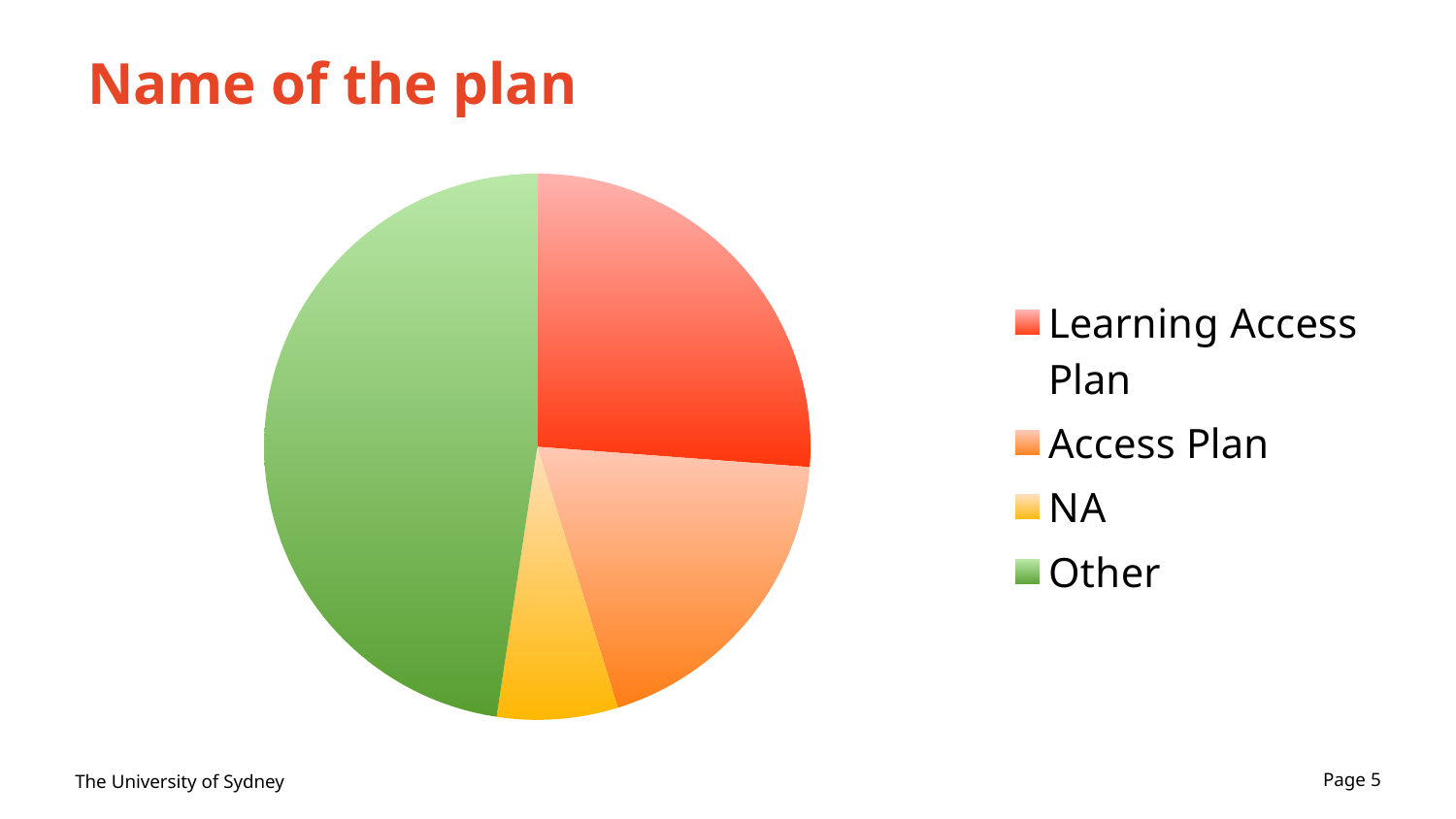
What kind of chart is shown on the slide? Pie chart What colour is the slice for Other in the pie chart? Green Which category has the largest slice of the pie? Other Which category has the smallest slice of the pie? NA Which slice is larger, Other or Learning Access Plan? Other Which category is listed first in the legend? Learning Access Plan What is the title of the chart on the slide? Name of the plan Which slice is larger, Access Plan or NA? Access Plan Which slice is larger, Learning Access Plan or Access Plan? Learning Access Plan How many categories (slices) does the pie chart have? 4